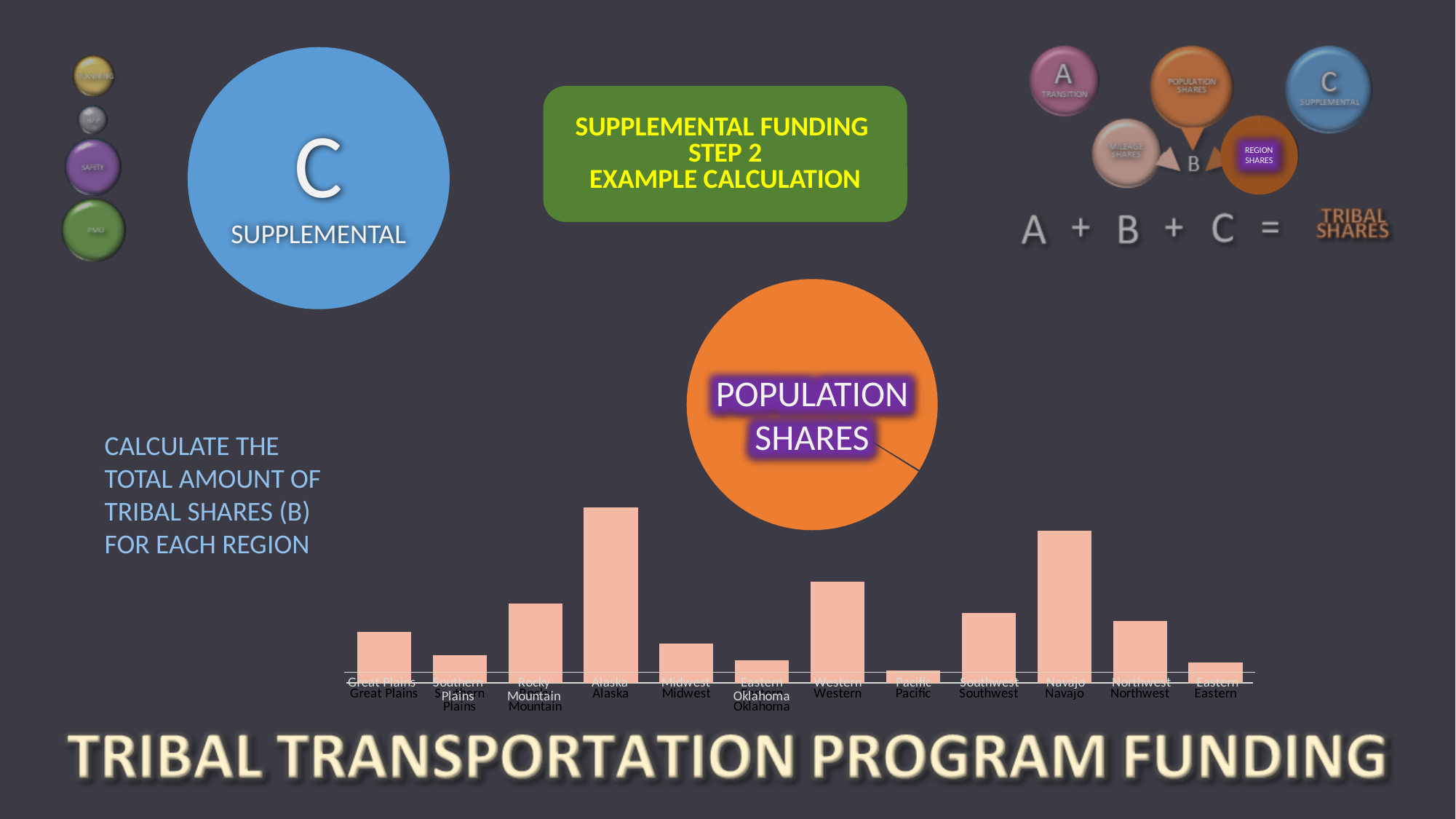
Which bar is taller, Alaska or Navajo? Alaska Which bar is taller, Midwest or Eastern Oklahoma? Midwest What label in the orange circle points to the bar chart? POPULATION SHARES Which bar is taller, Great Plains or Southern Plains? Great Plains Which region has the second tallest bar in the chart? Navajo Which region has the shortest bar in the chart? Pacific Which region has the tallest bar in the chart? Alaska How many regions are shown as categories in the bar chart? 12 What kind of chart is shown at the bottom of the slide? bar chart